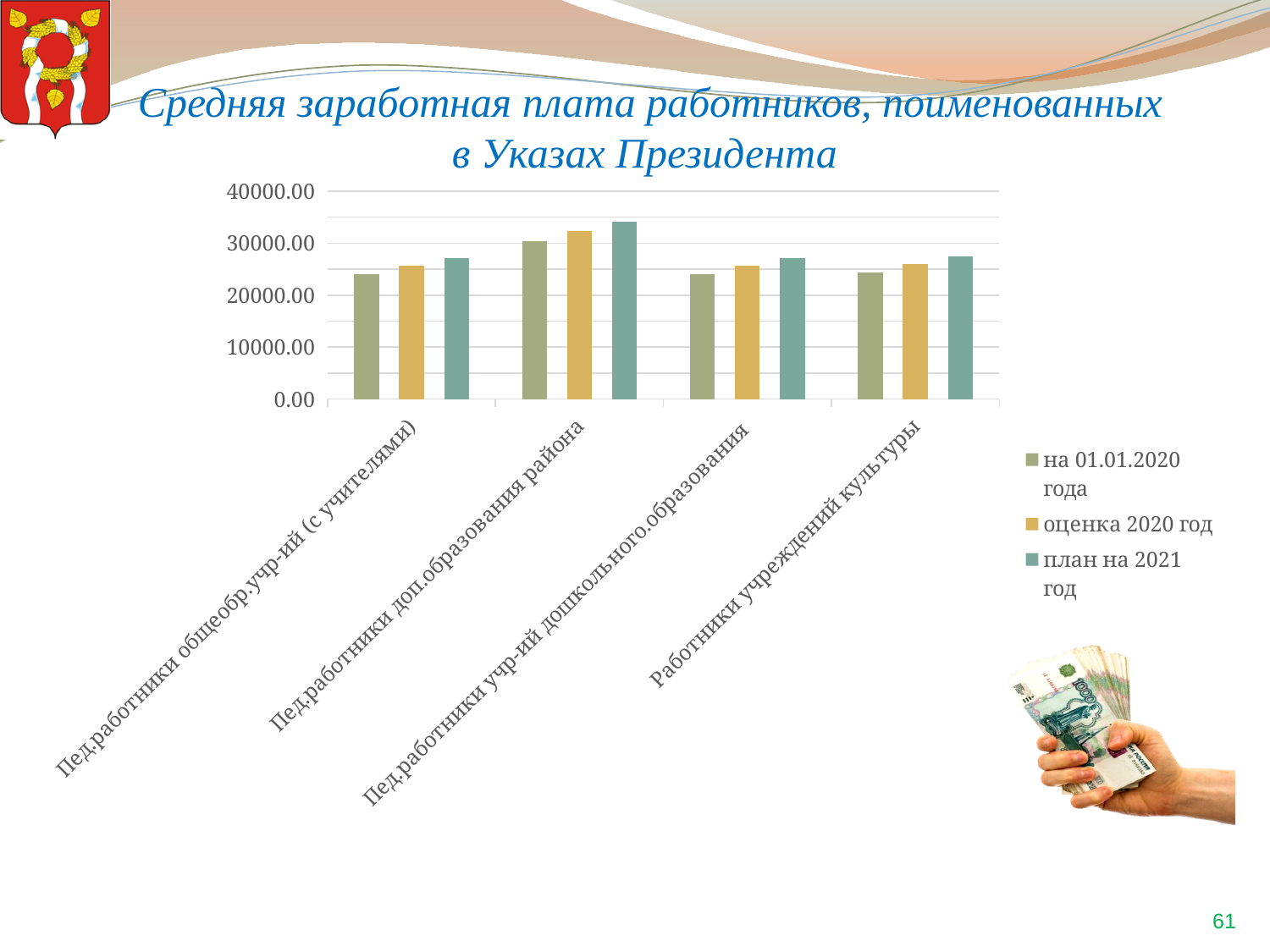
Is the value for 'Пед.работники доп.образования района' in the series 'план на 2021 год' greater or less than 30000.00? greater How many series does the legend list? 3 What type of chart is shown on the slide? bar chart Which category has the highest value for the series 'план на 2021 год'? Пед.работники доп.образования района What is the title of the chart on the slide? Средняя заработная плата работников, поименованных в Указах Президента Is the value for 'Работники учреждений культуры' in the series 'план на 2021 год' greater or less than 20000.00? greater For the series 'план на 2021 год', which is larger: the value for 'Пед.работники доп.образования района' or for 'Пед.работники общеобр.учр-ий (с учителями)'? Пед.работники доп.образования района Is the value for 'Пед.работники общеобр.учр-ий (с учителями)' in the series 'на 01.01.2020 года' greater or less than 30000.00? less Which category has the highest value for the series 'оценка 2020 год'? Пед.работники доп.образования района Within the category 'Пед.работники доп.образования района', do the values rise or fall from 'на 01.01.2020 года' to 'план на 2021 год'? rise How many categories are shown on the x axis of the chart? 4